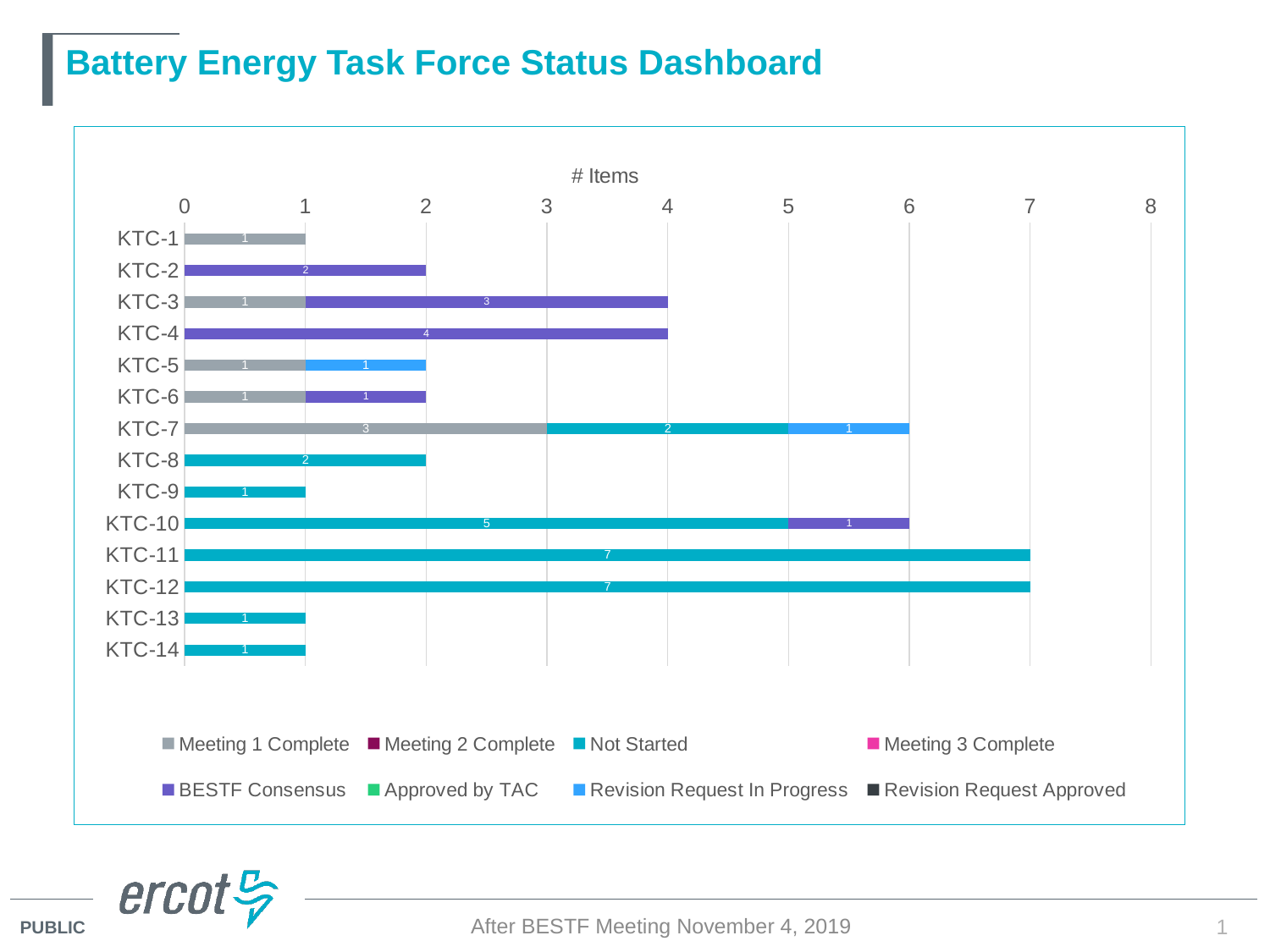
What is the total number of items in the stacked bar for KTC-3? 4 What is the total number of items in the stacked bar for KTC-7? 6 How many KTC categories are plotted on the chart? 14 What kind of chart is shown on the slide? bar chart What is the Revision Request In Progress value for KTC-5? 1 What is the title shown above the chart's horizontal axis? # Items Which has the larger total bar, KTC-4 or KTC-2? KTC-4 What is the Not Started value for KTC-10? 5 What is the difference between the Not Started value for KTC-11 and the Not Started value for KTC-8? 5 What is the Meeting 1 Complete value for KTC-7? 3 What is the BESTF Consensus value for KTC-4? 4 How many series does the chart's legend list? 8